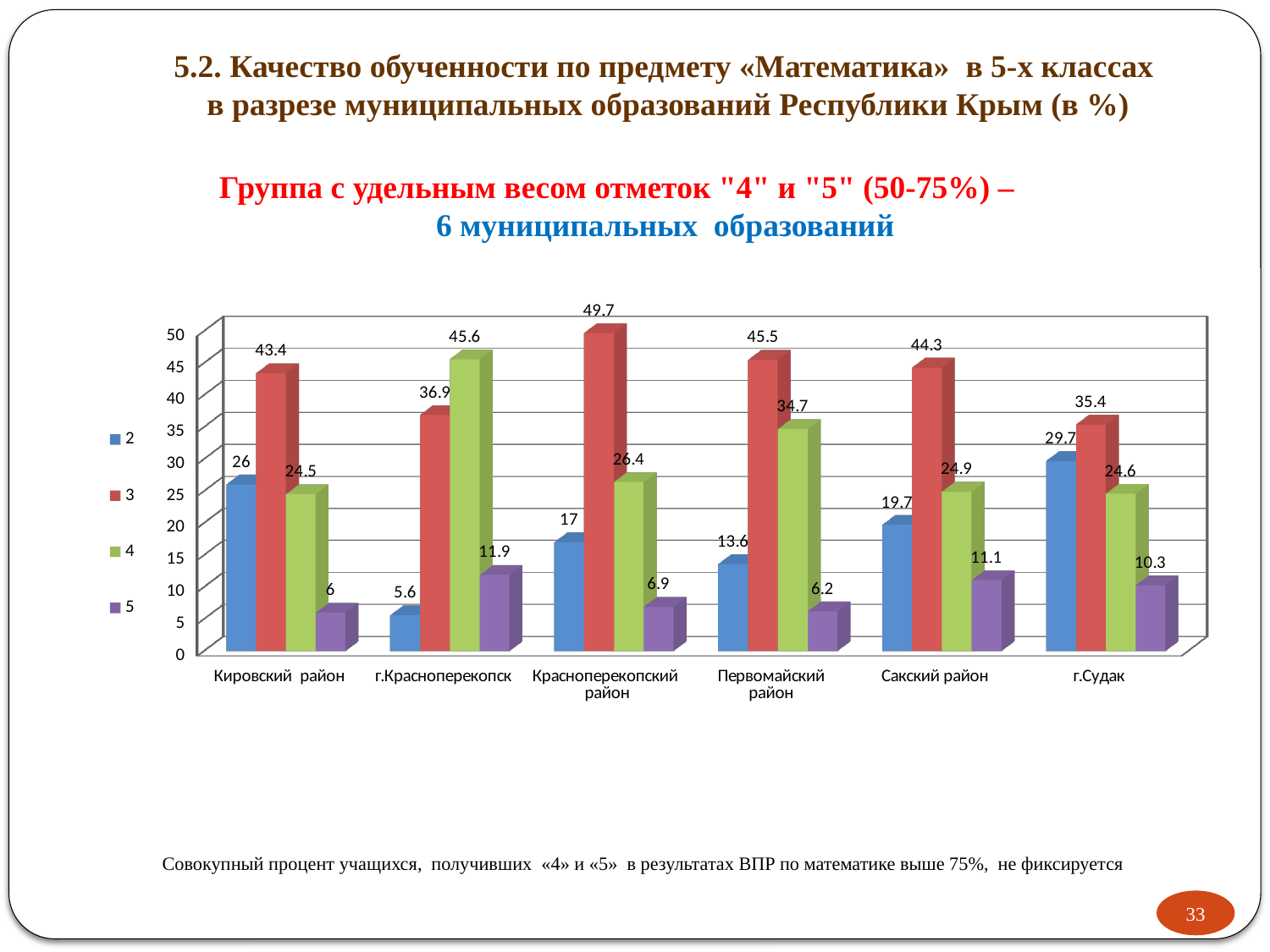
What is the total of the four series values for Кировский район? 99.9 What kind of chart is shown on the slide? bar chart What is the value for series "3" in Красноперекопский район? 49.7 Which category has the lowest value for series "2"? г.Красноперекопск Which category has the highest value for series "3"? Красноперекопский район What is the value for series "5" in Сакский район? 11.1 How many categories (municipalities) are shown on the x axis? 6 How many series does the legend list? 4 Which category has the highest value for series "4"? г.Красноперекопск Which is larger in Первомайский район: the value for series "3" or the value for series "4"? series "3" (45.5) What is the difference between the series "3" value and the series "2" value in г.Судак? 5.7 What is the value for series "2" in г.Красноперекопск? 5.6